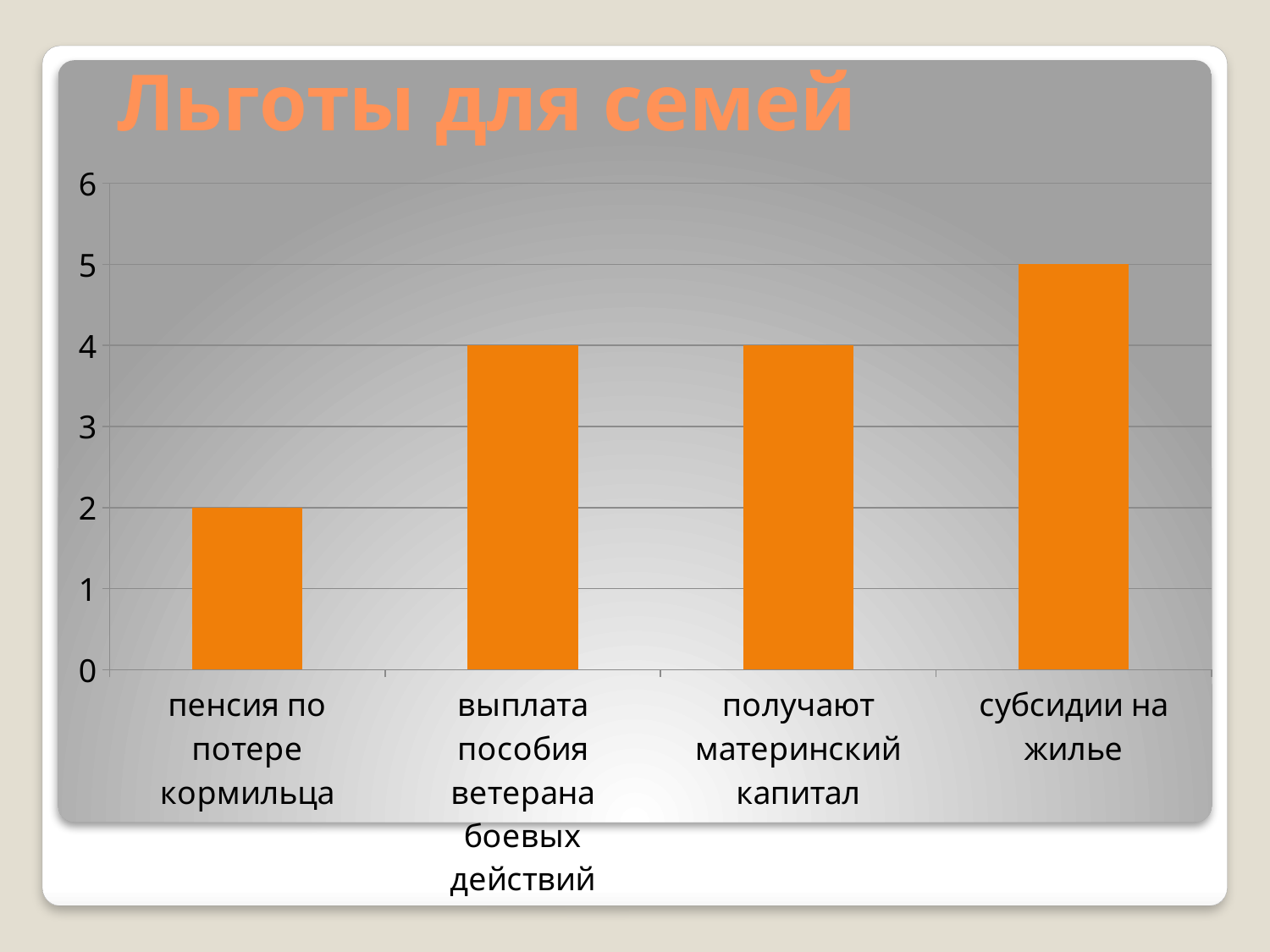
What is the title of the chart? Льготы для семей Which category has the highest value? субсидии на жилье What type of chart is shown on the slide? bar chart Is the value for "субсидии на жилье" greater or less than 3? greater Which is larger, the value for "выплата пособия ветерана боевых действий" or the value for "пенсия по потере кормильца"? выплата пособия ветерана боевых действий What is the value for "пенсия по потере кормильца"? 2 What is the value for "субсидии на жилье"? 5 Which category has the lowest value? пенсия по потере кормильца What is the value for "получают материнский капитал"? 4 What is the difference between the values for "субсидии на жилье" and "пенсия по потере кормильца"? 3 What colour are the bars in the chart? orange How many categories are shown on the x axis of the chart? 4